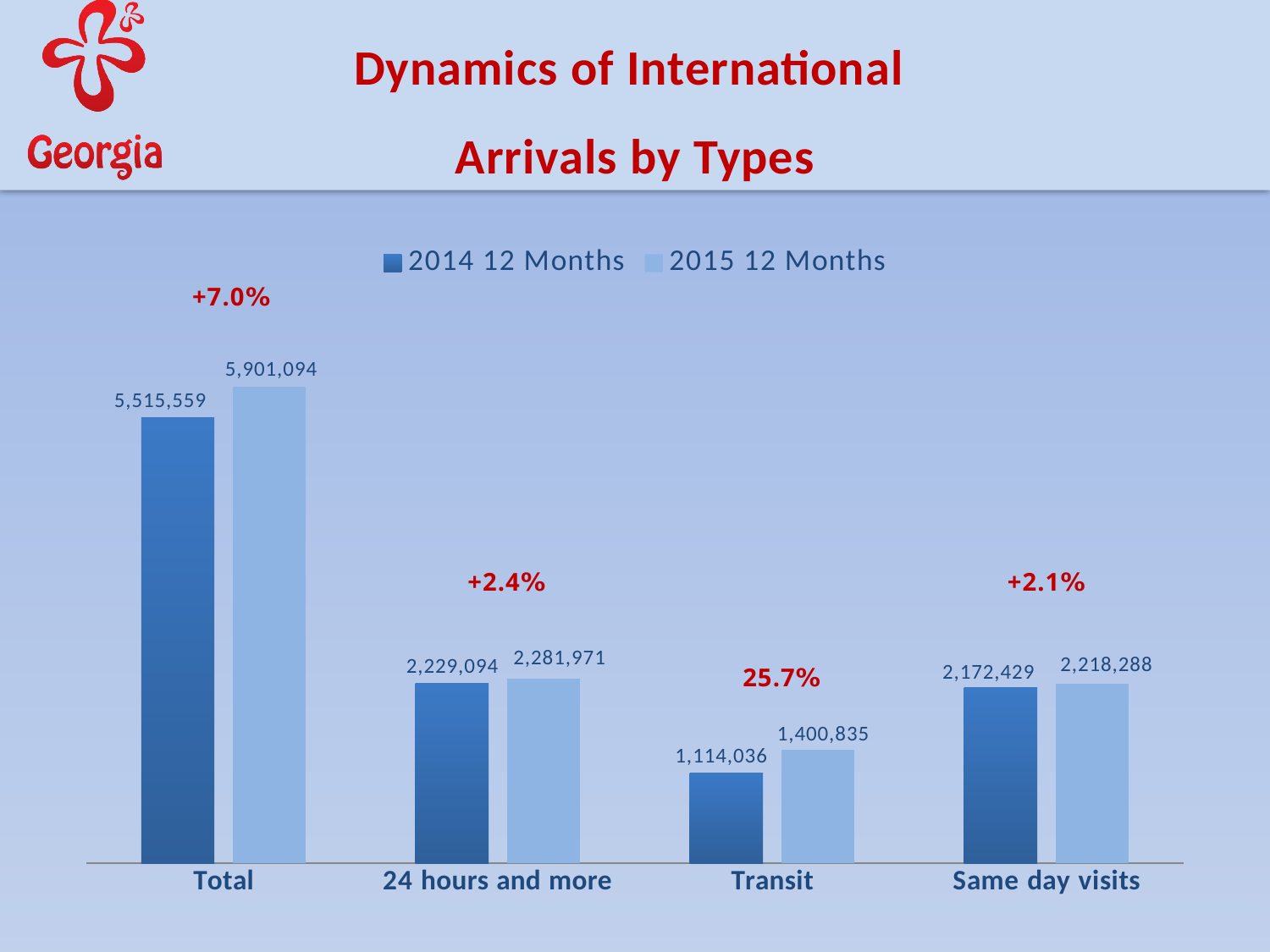
How many categories are shown on the x axis? 4 What is the difference between the 2015 12 Months and 2014 12 Months values for Total? 385,535 What kind of chart is shown on the slide? Bar chart Which category has the lowest value in the 2014 12 Months series? Transit What is the value for Same day visits in the 2014 12 Months series? 2,172,429 Which is larger: the 2014 12 Months value for 24 hours and more or the 2014 12 Months value for Same day visits? 24 hours and more What is the value for 24 hours and more in the 2015 12 Months series? 2,281,971 How many series does the legend list? 2 What is the value for Total in the 2014 12 Months series? 5,515,559 What is the value for Transit in the 2015 12 Months series? 1,400,835 Which category has the highest value in the 2015 12 Months series? Total What is the difference between the 2015 12 Months and 2014 12 Months values for Transit? 286,799